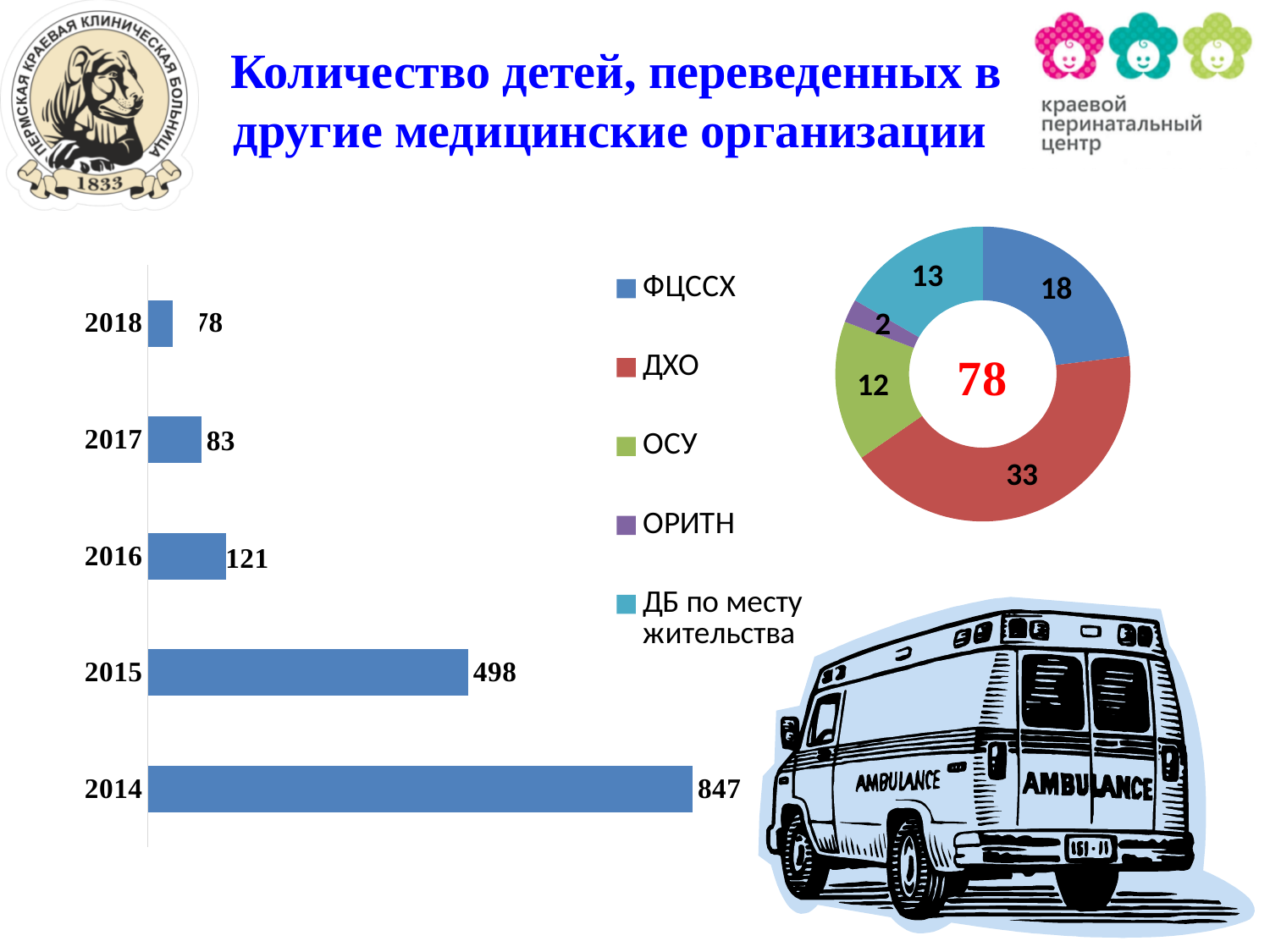
In the bar chart on the left, what is the difference between the values for 2015 and 2016? 377 In the doughnut chart on the right, what is the value for ДХО? 33 In the bar chart on the left, which year has the highest value? 2014 In the bar chart on the left, how many years are shown? 5 What kind of chart is the chart on the left of the slide? bar chart In the doughnut chart on the right, which category has the smallest value? ОРИТН In the bar chart on the left, what is the value for 2014? 847 In the bar chart on the left, which year has the lowest value? 2018 In the doughnut chart on the right, what number is shown in the centre? 78 In the bar chart on the left, what is the value for 2016? 121 In the bar chart on the left, do the values rise or fall from 2014 to 2018? fall In the doughnut chart on the right, how many categories does the legend list? 5